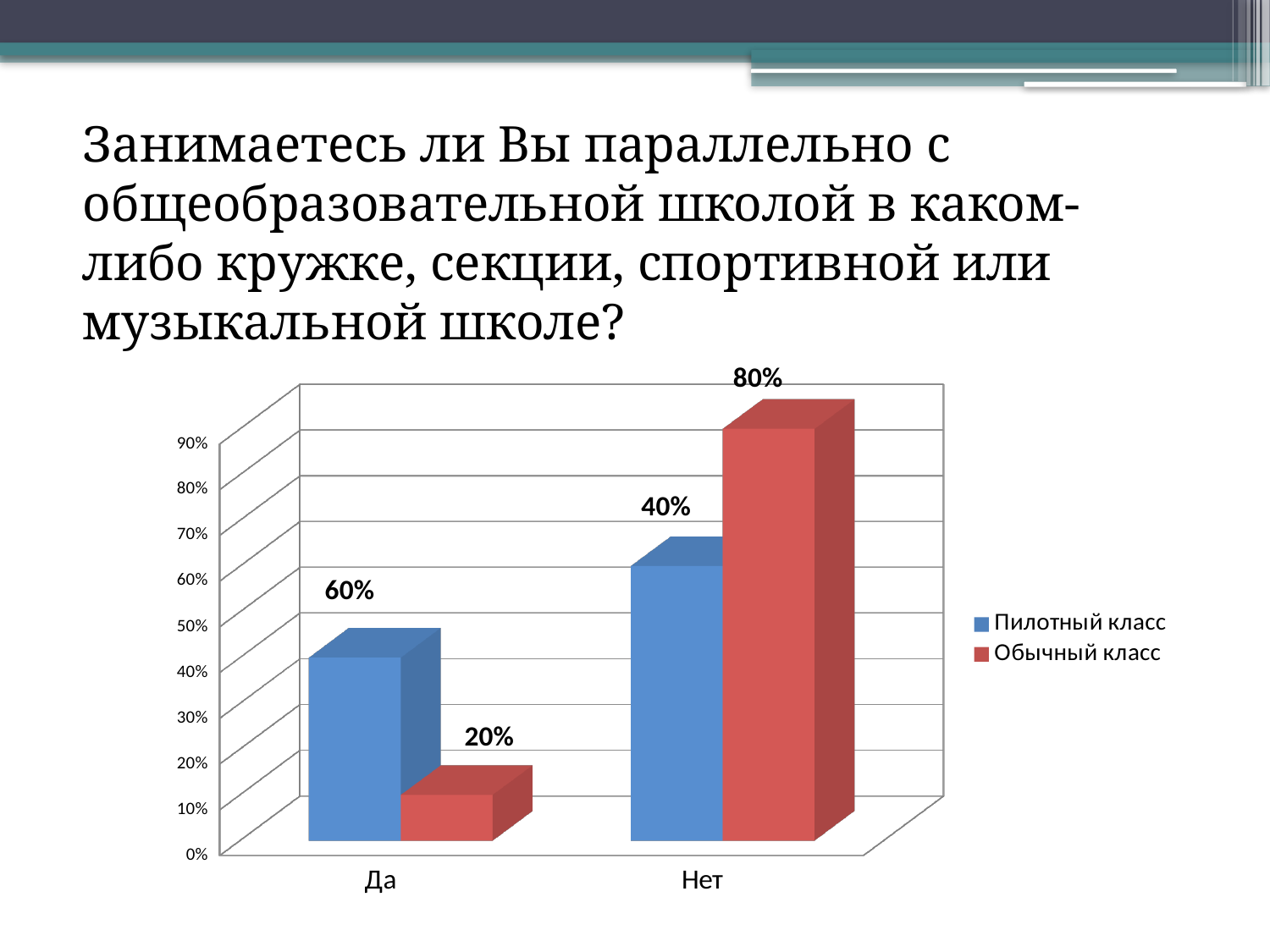
In the Да category, which series has the larger value, Пилотный класс or Обычный класс? Пилотный класс What is the difference between Обычный класс and Пилотный класс in the Нет category? 40% What is the value for Пилотный класс in the Да category? 60% What kind of chart is shown on the slide? Bar chart How many categories are shown on the x axis? 2 Which category has the lowest value for Пилотный класс? Нет What is the value for Пилотный класс in the Нет category? 40% How many series does the legend list? 2 What is the value for Обычный класс in the Да category? 20% Which category has the highest value for Обычный класс? Нет Which colour represents Обычный класс in the legend? Red What is the value for Обычный класс in the Нет category? 80%